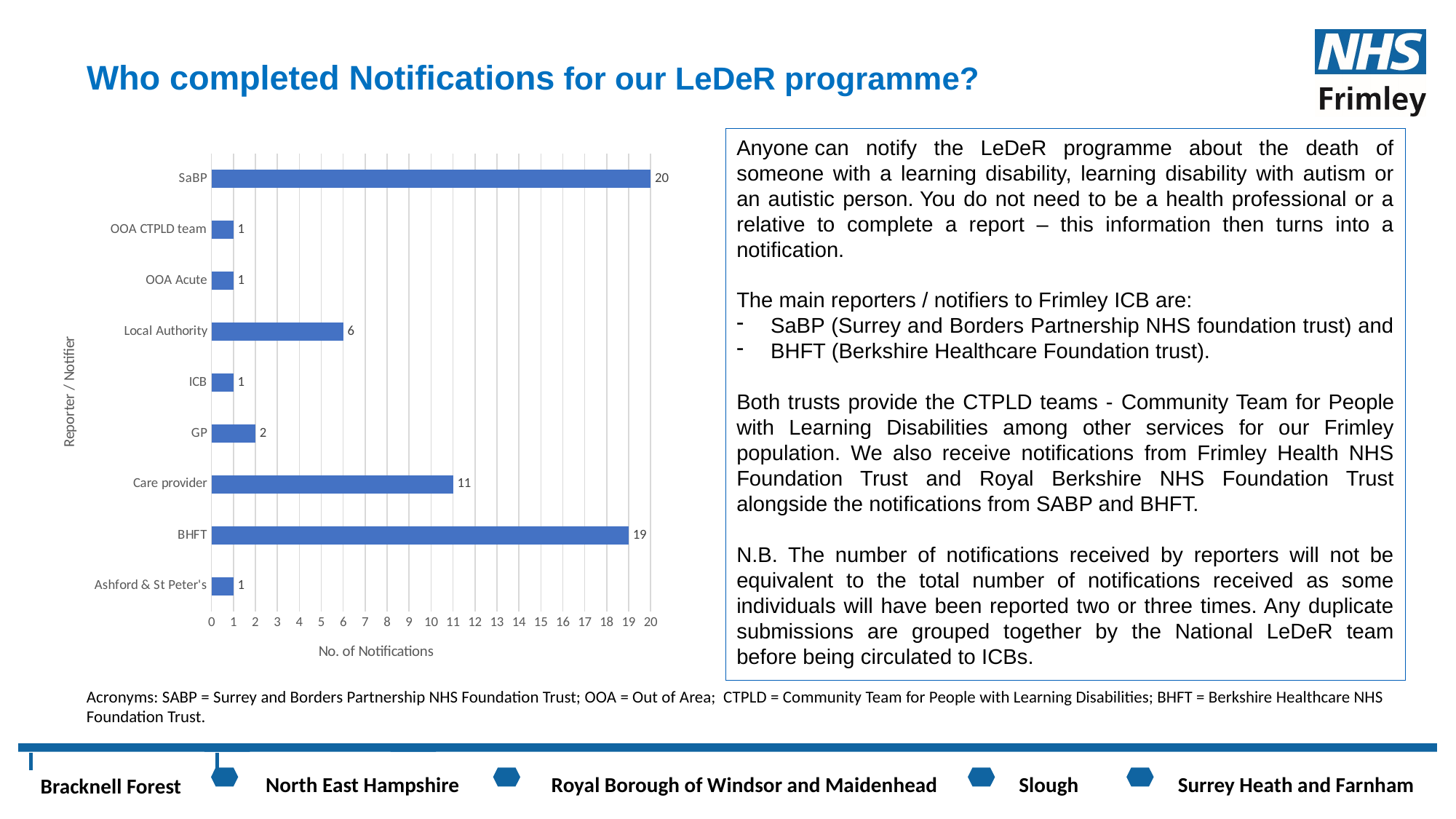
How many notifications did Local Authority complete? 6 Which completed more notifications, GP or Local Authority? Local Authority How many reporter / notifier categories are shown on the chart? 9 What is the difference in notifications between Care provider and Local Authority? 5 What kind of chart is shown on the slide? Bar chart What is the label of the horizontal axis of the chart? No. of Notifications What is the label of the vertical axis of the chart? Reporter / Notifier How many notifications did SaBP complete? 20 Which completed more notifications, BHFT or Care provider? BHFT Which reporter / notifier completed the most notifications? SaBP How many notifications did Care provider complete? 11 What is the difference in notifications between SaBP and BHFT? 1